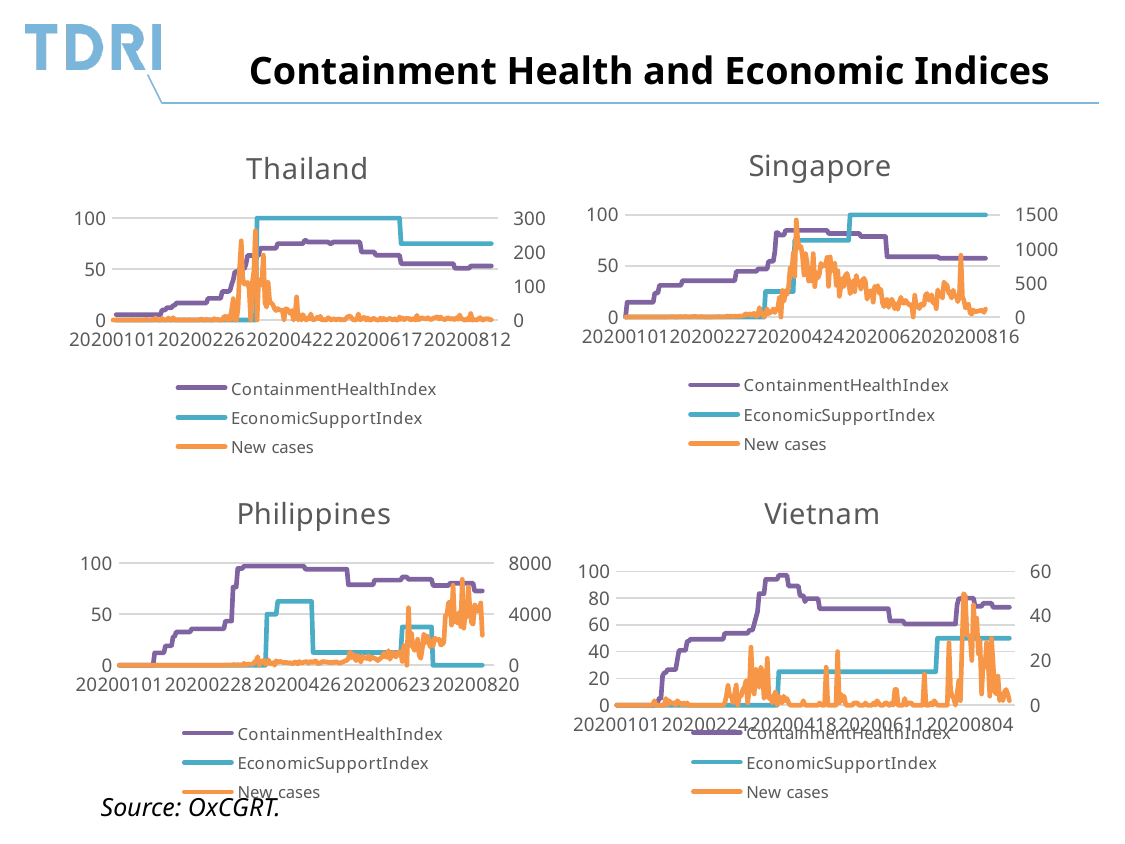
In the Thailand chart, is the ContainmentHealthIndex value in January 2020 greater or less than 50? less In the Singapore chart, at the end of the period, which is higher: ContainmentHealthIndex or EconomicSupportIndex? EconomicSupportIndex In the Philippines chart, what is the highest tick shown on the right-hand axis? 8000 Which countries have charts on the slide? Thailand, Singapore, Philippines, Vietnam In the Thailand chart, is the peak value of EconomicSupportIndex greater or less than 50? greater How many series does the legend of the Singapore chart list? 3 In the Thailand chart, does the ContainmentHealthIndex rise or fall between January and April 2020? rise In the Singapore chart, is the EconomicSupportIndex value in July 2020 greater or less than 50? greater In the Thailand chart, does the EconomicSupportIndex rise or fall between June and August 2020? fall What kind of chart is the Thailand chart? line chart In the Thailand chart, at the end of the period, which is higher: ContainmentHealthIndex or EconomicSupportIndex? EconomicSupportIndex